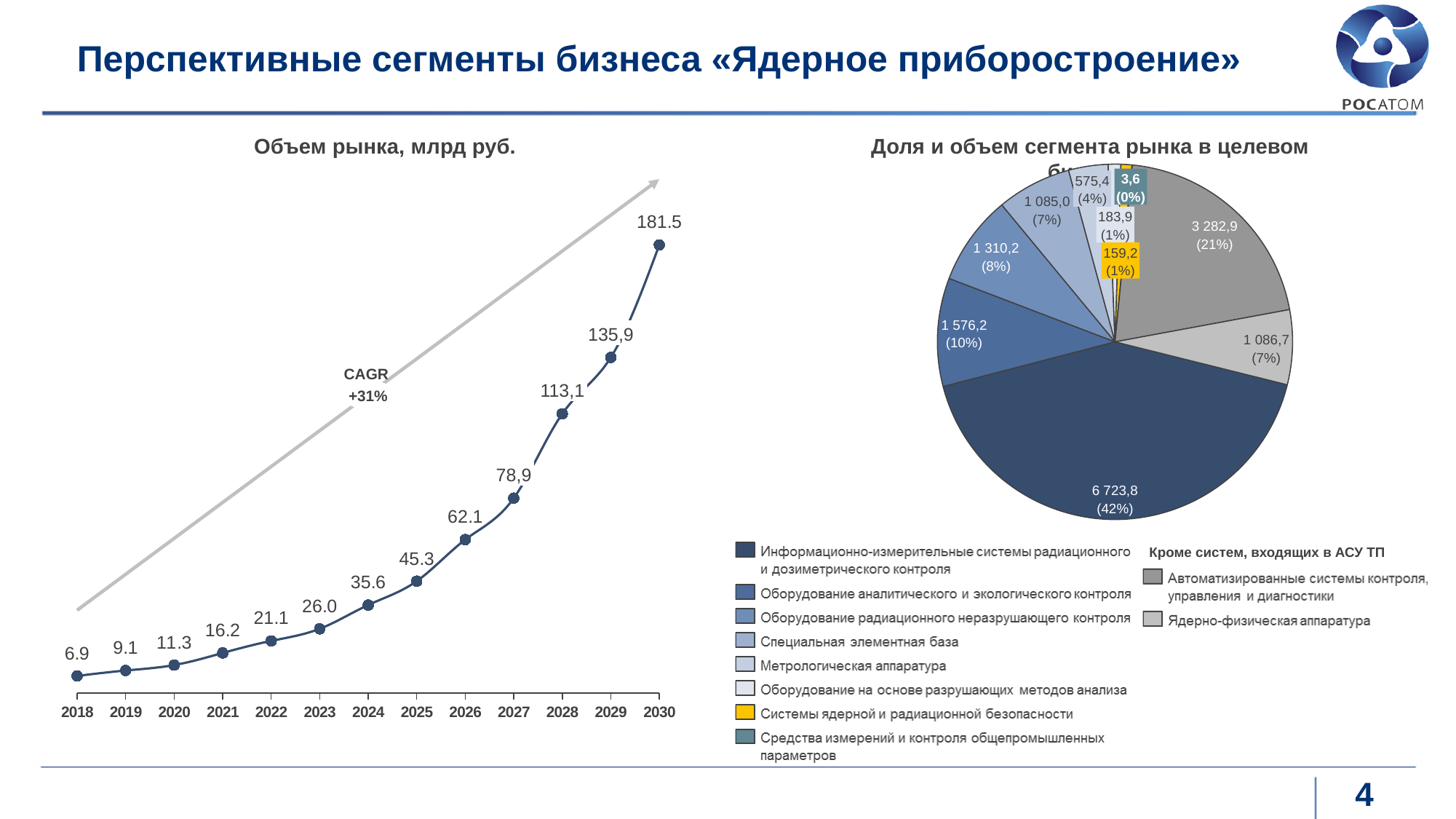
In the chart 'Объем рынка, млрд руб.', what is the value for 2018? 6.9 In the chart 'Объем рынка, млрд руб.', what is the value for 2030? 181.5 In the chart 'Объем рынка, млрд руб.', which year has the highest value? 2030 In the pie chart on the right, which segment has the largest slice? Информационно-измерительные системы радиационного и дозиметрического контроля In the chart 'Объем рынка, млрд руб.', what is the difference between the values for 2029 and 2028? 22,8 In the chart 'Объем рынка, млрд руб.', what CAGR is shown next to the grey arrow? +31% In the chart 'Объем рынка, млрд руб.', do the values rise or fall from 2018 to 2030? Rise What kind of chart is the left chart 'Объем рынка, млрд руб.'? Line chart In the chart 'Объем рынка, млрд руб.', which year has the lowest value? 2018 In the chart 'Объем рынка, млрд руб.', how many years are plotted? 13 In the pie chart on the right, what share does the slice for 'Информационно-измерительные системы радиационного и дозиметрического контроля' have? 42% In the pie chart on the right, what is the value for 'Автоматизированные системы контроля, управления и диагностики'? 3 282,9